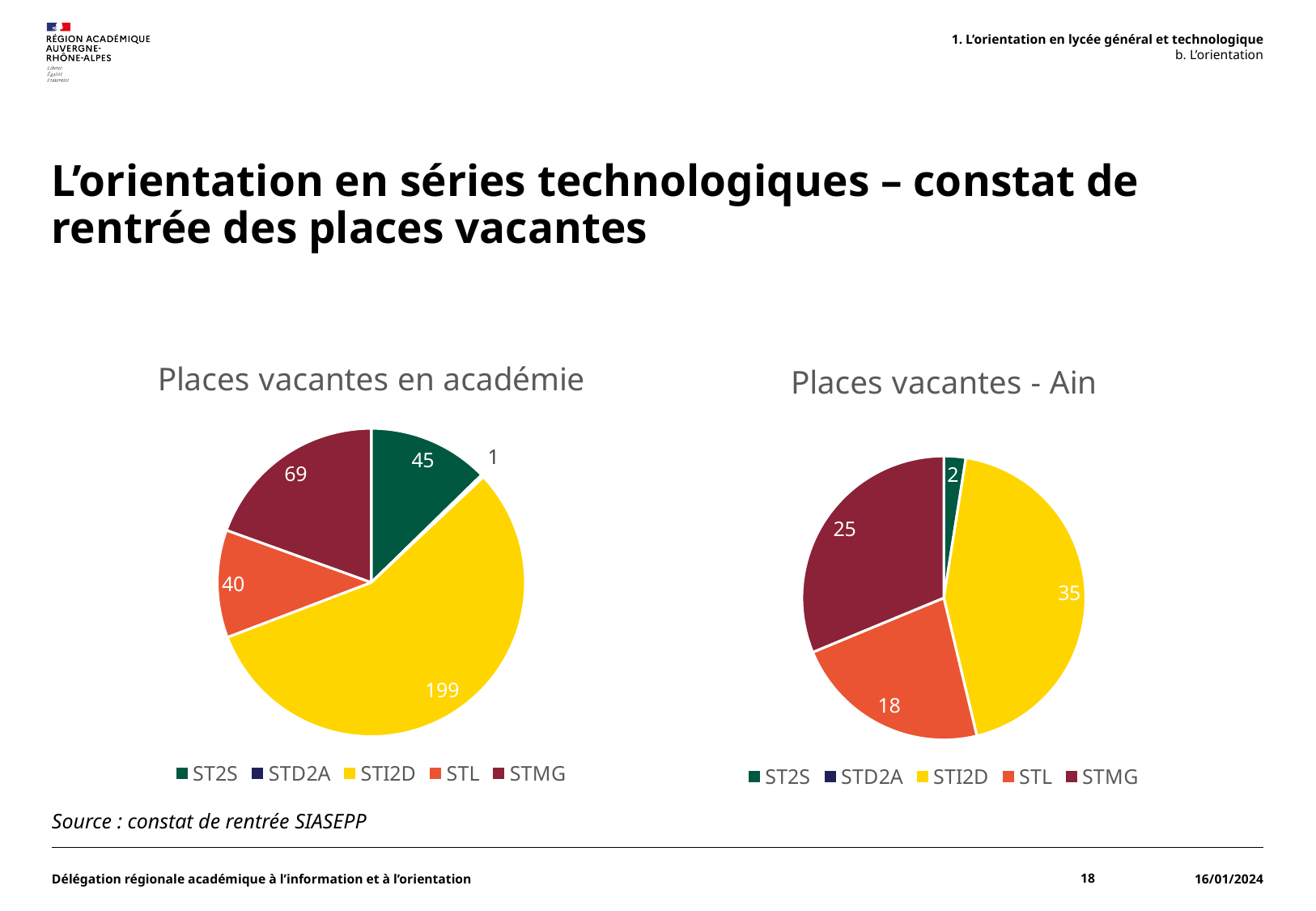
In the 'Places vacantes en académie' chart, what is the difference between the STMG and STL values? 29 In the 'Places vacantes en académie' chart, what is the value for STMG? 69 In the 'Places vacantes - Ain' chart, what is the value for STL? 18 In the 'Places vacantes - Ain' chart, which series has the largest slice? STI2D What type of chart is 'Places vacantes en académie'? Pie chart How many series does the legend of the 'Places vacantes - Ain' chart list? 5 In the 'Places vacantes en académie' chart, which labelled series has the smallest value? STD2A In the 'Places vacantes en académie' chart, how many places vacantes are shown for STI2D? 199 In the 'Places vacantes - Ain' chart, what is the value for ST2S? 2 In the 'Places vacantes - Ain' chart, what is the difference between the STI2D and STMG values? 10 In the 'Places vacantes en académie' chart, which series has the largest slice? STI2D In the 'Places vacantes - Ain' chart, which is larger, STMG or STL? STMG